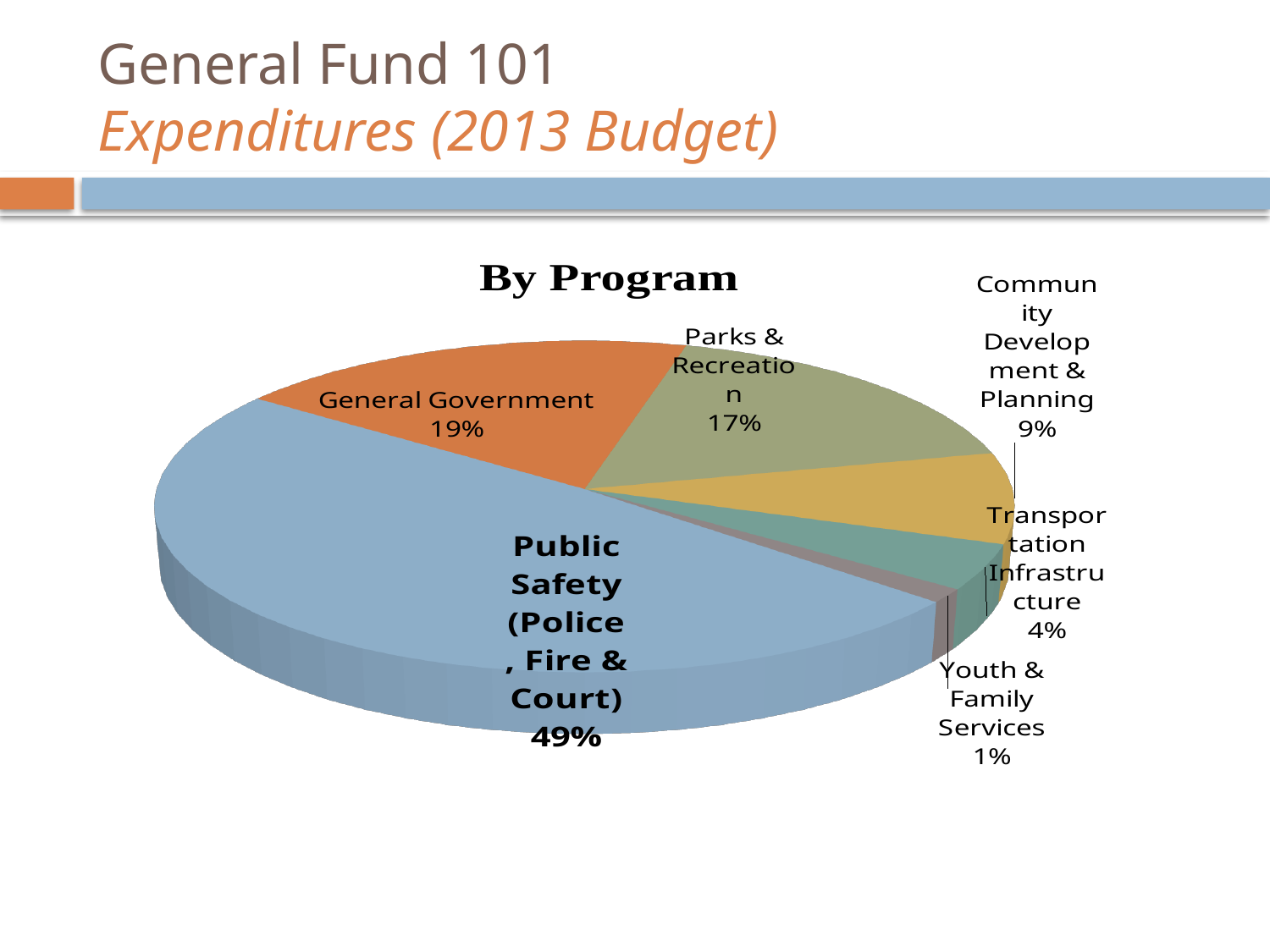
What percentage is shown for Community Development & Planning? 9% What share does Parks & Recreation represent? 17% What is the difference in percentage points between General Government and Parks & Recreation? 2% Which program has the largest share of expenditures? Public Safety (Police, Fire & Court) What percentage of the pie is General Government? 19% What share of expenditures goes to Public Safety (Police, Fire & Court)? 49% What type of chart is shown on the slide? pie chart What is the title of the chart? By Program What share of the pie is Transportation Infrastructure? 4% Which is larger, the share for Community Development & Planning or the share for Transportation Infrastructure? Community Development & Planning Which program has the smallest share of expenditures? Youth & Family Services What percentage is Youth & Family Services? 1%